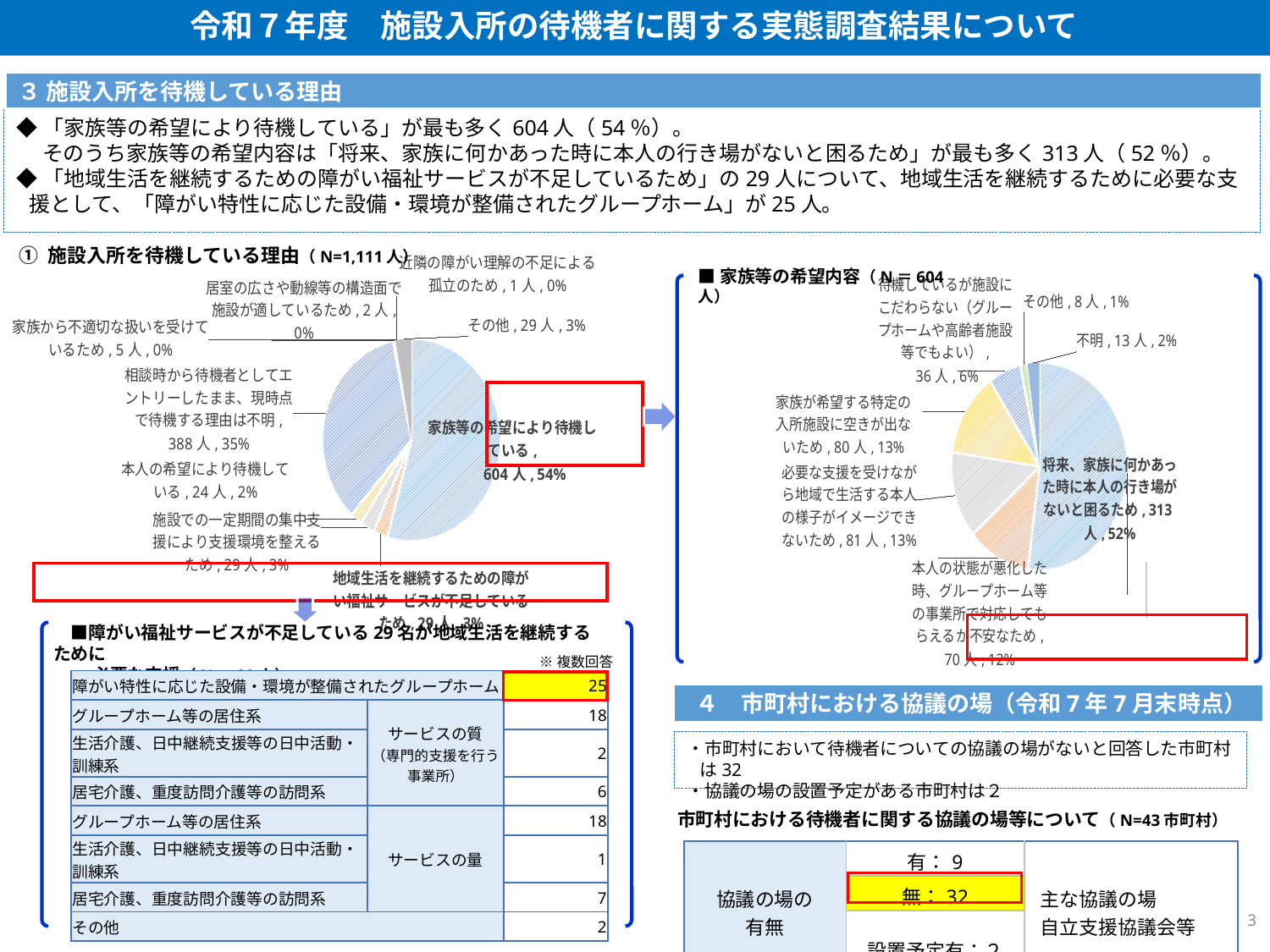
右の円グラフ「家族等の希望内容」は何種類のグラフですか？ 円グラフ 左の円グラフ「施設入所を待機している理由」で、「家族等の希望により待機している」の割合は何％ですか？ 54% 左の円グラフ「施設入所を待機している理由」のNはいくつですか？ N=1,111人 右の円グラフ「家族等の希望内容」で、最も人数が少ない項目はどれですか？ その他 右の円グラフ「家族等の希望内容」で、「必要な支援を受けながら地域で生活する本人の様子がイメージできないため」と「家族が希望する特定の入所施設に空きが出ないため」の人数の差は何人ですか？ 1人 左の円グラフ「施設入所を待機している理由」で、「本人の希望により待機している」と「その他」ではどちらの人数が多いですか？ その他 左の円グラフ「施設入所を待機している理由」で、最も人数が少ない理由はどれですか？ 近隣の障がい理解の不足による孤立のため 右の円グラフ「家族等の希望内容」で、「本人の状態が悪化した時、グループホーム等の事業所で対応してもらえるか不安なため」の割合は何％ですか？ 12% 左の円グラフ「施設入所を待機している理由」で、最も人数が多い理由はどれですか？ 家族等の希望により待機している 左の円グラフ「施設入所を待機している理由」で、「家族等の希望により待機している」の人数は何人ですか？ 604人 右の円グラフ「家族等の希望内容」で、「将来、家族に何かあった時に本人の行き場がないと困るため」の人数は何人ですか？ 313人 左の円グラフ「施設入所を待機している理由」で、「家族等の希望により待機している」と「相談時から待機者としてエントリーしたまま、現時点で待機する理由は不明」の人数の差は何人ですか？ 216人